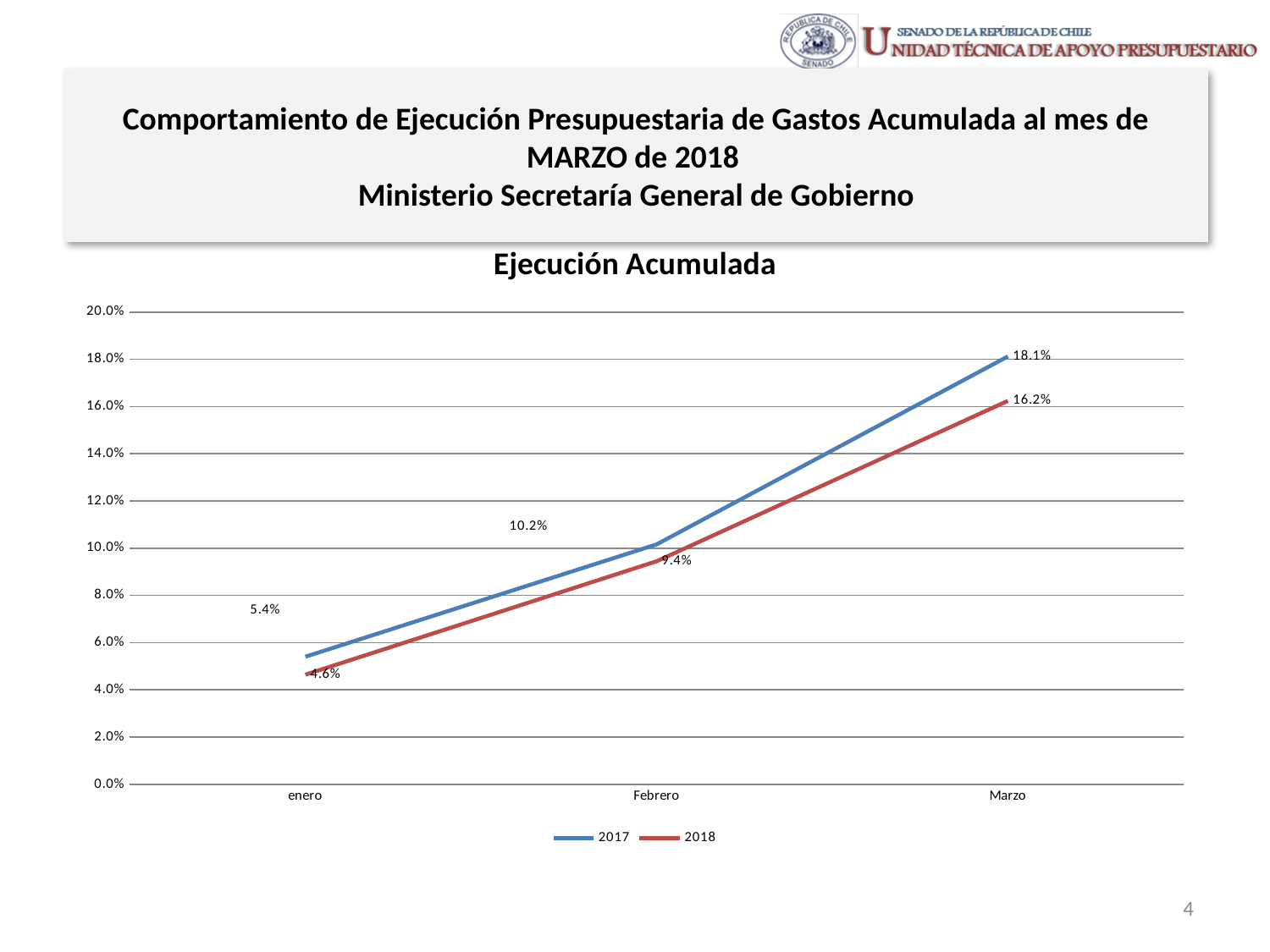
What is the value for 2017 in Marzo? 18.1% In which month is the 2018 series highest? Marzo Which series has the larger value in Febrero, 2017 or 2018? 2017 How many months are shown on the x axis? 3 What is the value for 2018 in Febrero? 9.4% What is the value for 2017 in enero? 5.4% Do the values for 2018 rise or fall from enero to Marzo? rise What is the value for 2018 in Marzo? 16.2% What is the difference between the 2017 and 2018 values in Marzo? 1.9% In which month is the 2017 series lowest? enero How many series does the legend list? 2 What type of chart is shown under the title "Ejecución Acumulada"? line chart